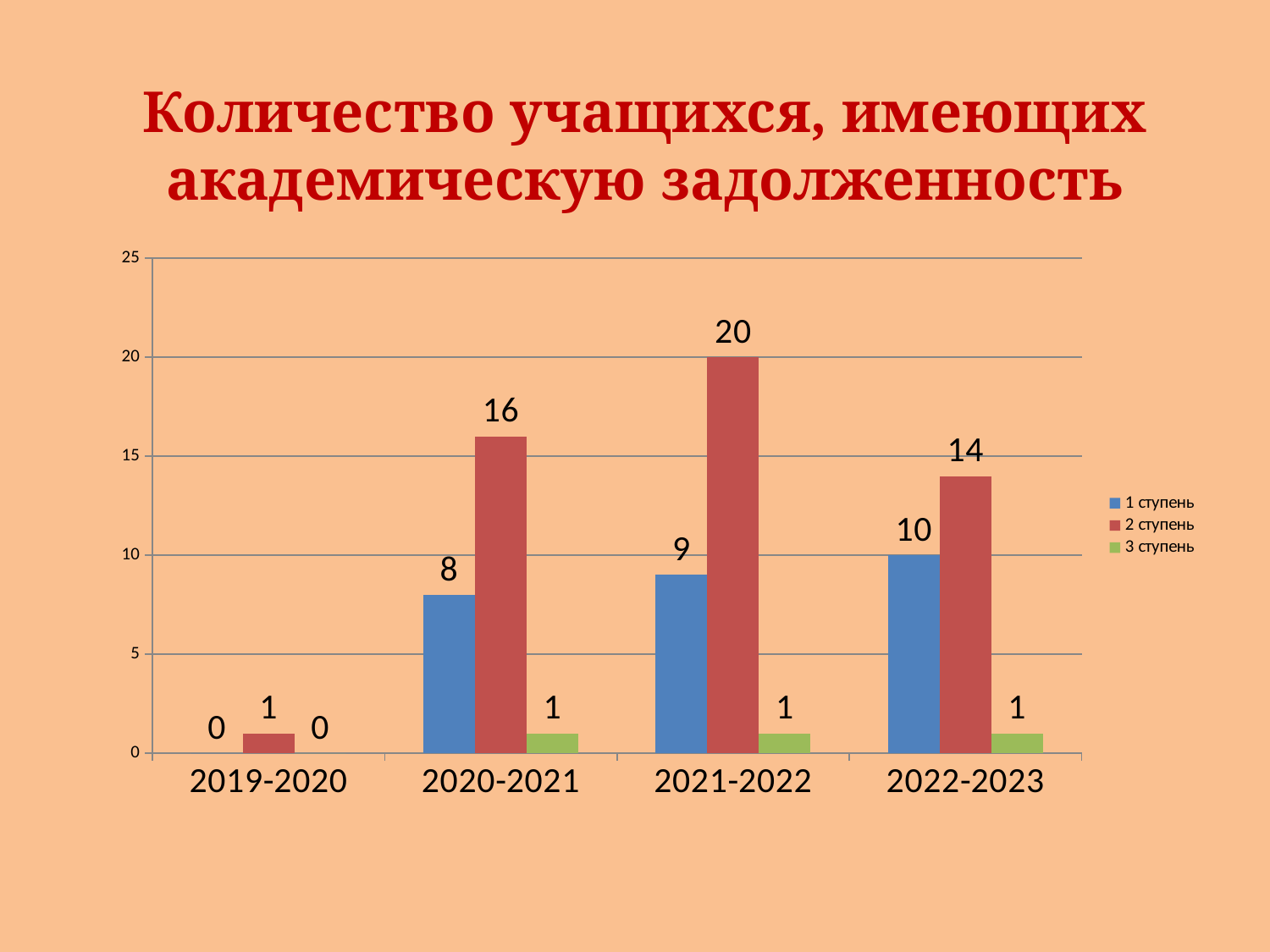
What is the value for 1 ступень in 2019-2020? 0 Does the value for 1 ступень rise or fall from 2020-2021 to 2022-2023? Rise In which year is the value for 1 ступень lowest? 2019-2020 What is the difference between 2 ступень and 1 ступень in 2022-2023? 4 What is the value for 3 ступень in 2022-2023? 1 What is the value for 2 ступень in 2021-2022? 20 What kind of chart is shown on the slide? Bar chart How many years are shown on the x axis? 4 How many series does the legend list? 3 What is the value for 1 ступень in 2020-2021? 8 Which is larger in 2020-2021: 1 ступень or 2 ступень? 2 ступень In which year is the value for 2 ступень highest? 2021-2022